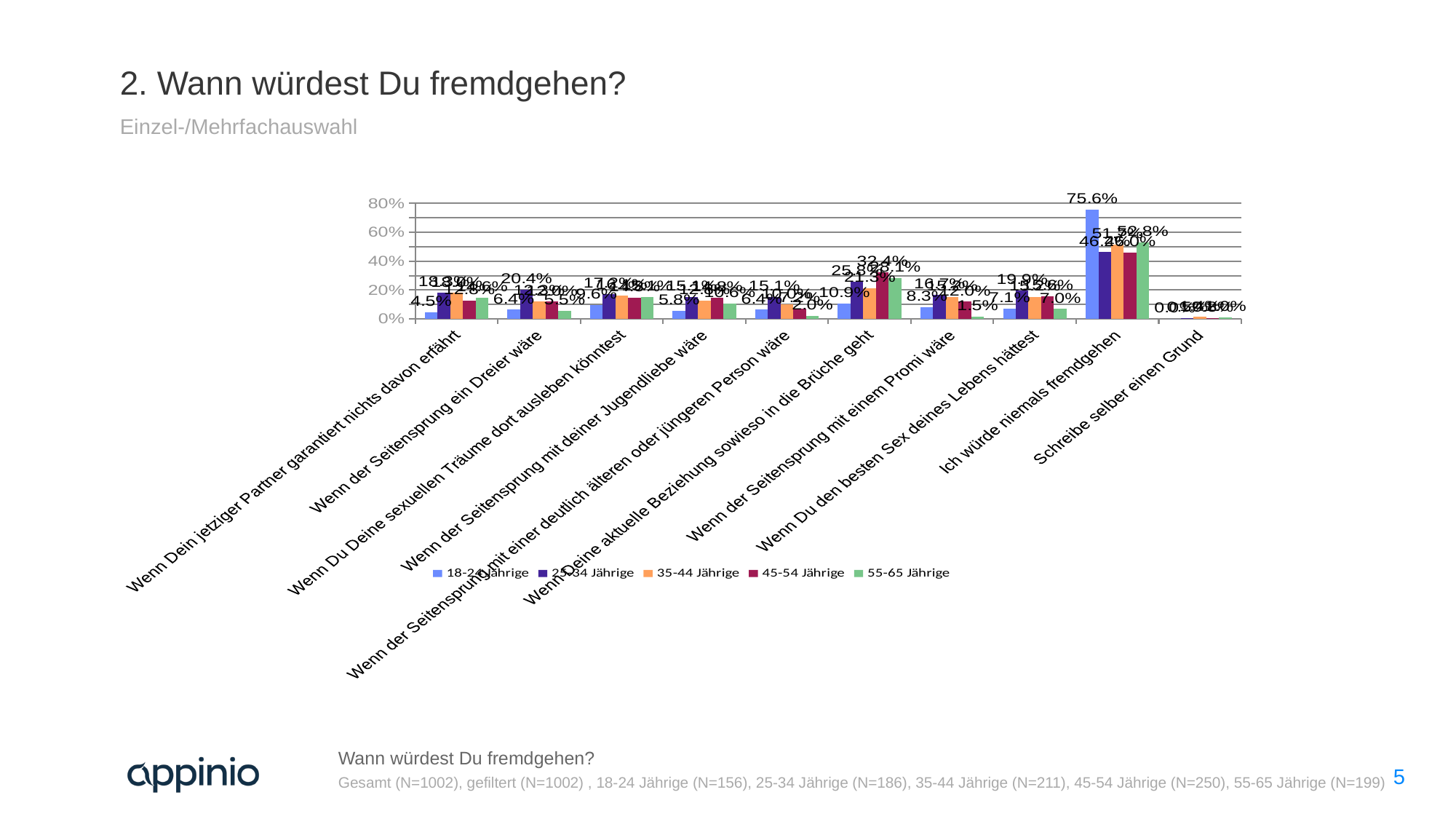
In the category 'Wenn der Seitensprung ein Dreier wäre', what is the difference between the values for 25-34 Jährige and 18-24 Jährige? 14.0 percentage points What is the value for 25-34 Jährige in the category 'Wenn der Seitensprung ein Dreier wäre'? 20.4% What is the value for 18-24 Jährige in the category 'Wenn Deine aktuelle Beziehung sowieso in die Brüche geht'? 10.9% What kind of chart is shown on the slide? bar chart Which age group has the highest value in the category 'Ich würde niemals fremdgehen'? 18-24 Jährige What is the value for 55-65 Jährige in the category 'Wenn der Seitensprung mit einer deutlich älteren oder jüngeren Person wäre'? 2.0% What is the value for 18-24 Jährige in the category 'Wenn Dein jetziger Partner garantiert nichts davon erfährt'? 4.5% How many series does the legend list? 5 In the category 'Ich würde niemals fremdgehen', which is larger: the value for 18-24 Jährige or for 25-34 Jährige? 18-24 Jährige What is the value for 18-24 Jährige in the category 'Ich würde niemals fremdgehen'? 75.6% Is the value for 18-24 Jährige in 'Ich würde niemals fremdgehen' greater or less than 60%? greater How many categories are shown on the x axis? 10